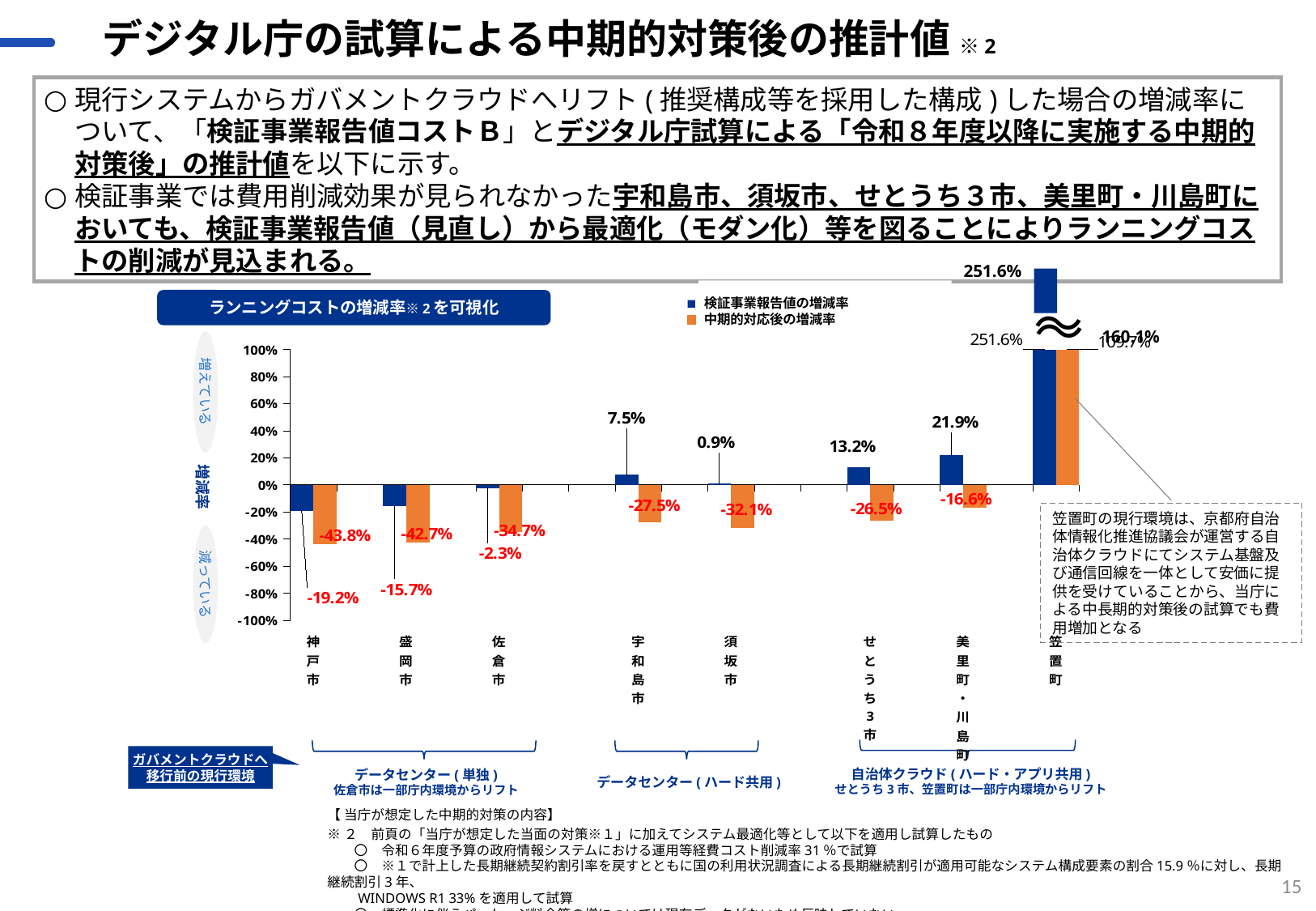
How many municipalities (categories) are shown on the x axis of the chart? 8 What is the 検証事業報告値の増減率 value for 神戸市? -19.2% For 神戸市, what is the difference between the 検証事業報告値の増減率 (-19.2%) and the 中期的対応後の増減率 (-43.8%)? 24.6 percentage points Which category has the lowest 中期的対応後の増減率? 神戸市 What is the 中期的対応後の増減率 value for 盛岡市? -42.7% What is the 検証事業報告値の増減率 value for 笠置町? 251.6% How many series does the chart legend list? 2 Which has the larger 検証事業報告値の増減率, 宇和島市 or 須坂市? 宇和島市 What kind of chart is shown on the slide? Bar chart Which category has the highest 検証事業報告値の増減率? 笠置町 What is the 中期的対応後の増減率 value for 須坂市? -32.1% What is the 検証事業報告値の増減率 value for 美里町・川島町? 21.9%